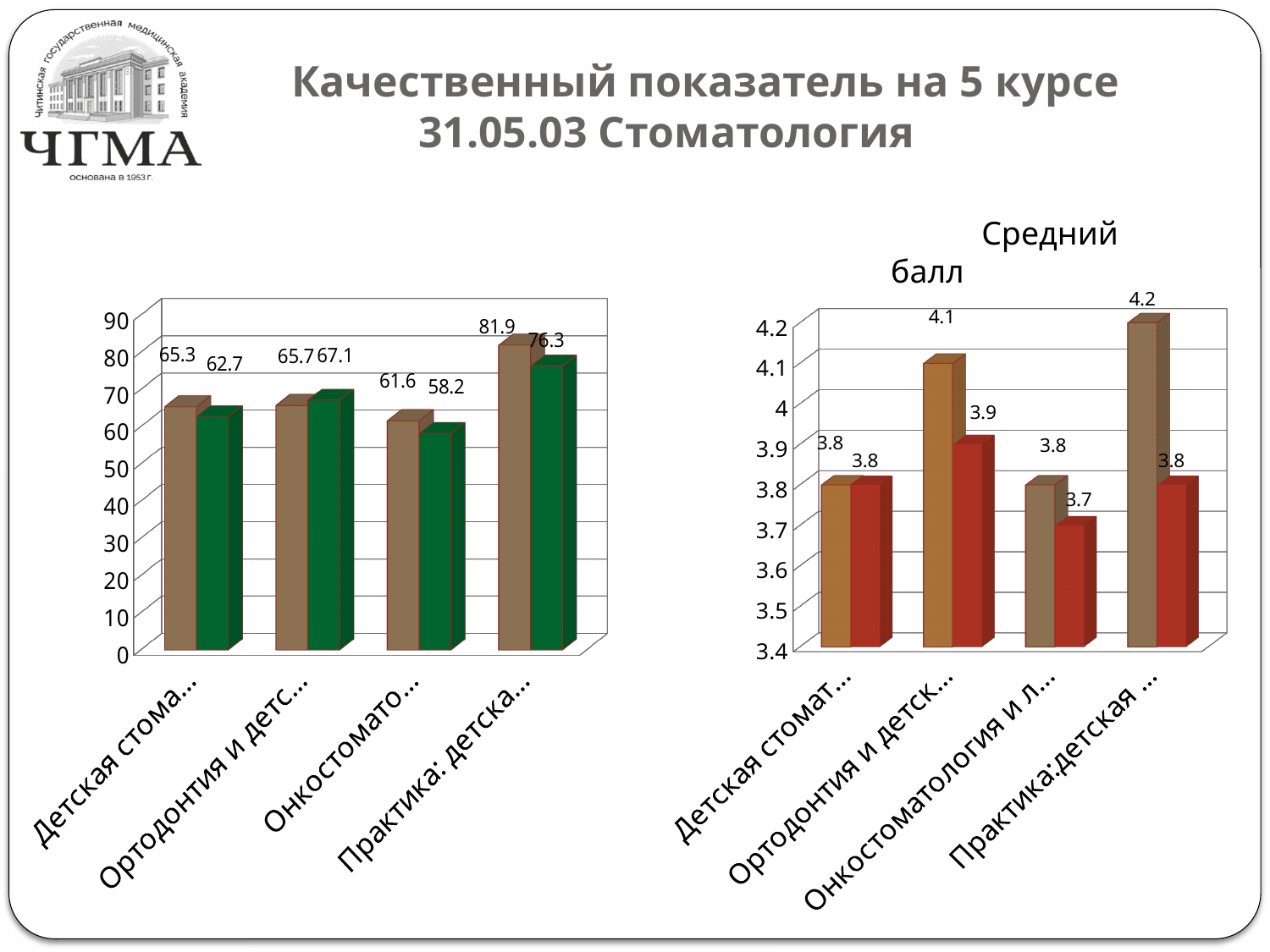
On the left chart, what is the value of the green bar for Онкостомато...? 58.2 On the right chart titled Средний балл, which category has the highest brown bar? Практика:детская ... On the right chart titled Средний балл, what is the value of the red bar for Онкостоматология и л...? 3.7 How many categories are shown on the right chart titled Средний балл? 4 On the left chart, what is the value of the green bar for Ортодонтия и детс...? 67.1 On the left chart, for Ортодонтия и детс..., which bar is larger, the brown or the green? green On the left chart, what is the difference between the brown and green bars for Детская стома...? 2.6 On the right chart titled Средний балл, what is the value of the brown bar for Ортодонтия и детск...? 4.1 On the left chart, what is the value of the brown bar for Практика: детская...? 81.9 On the left chart, which category has the lowest green bar? Онкостомато... On the left chart, which category has the highest brown bar? Практика: детская... What type of chart is the left chart? bar chart